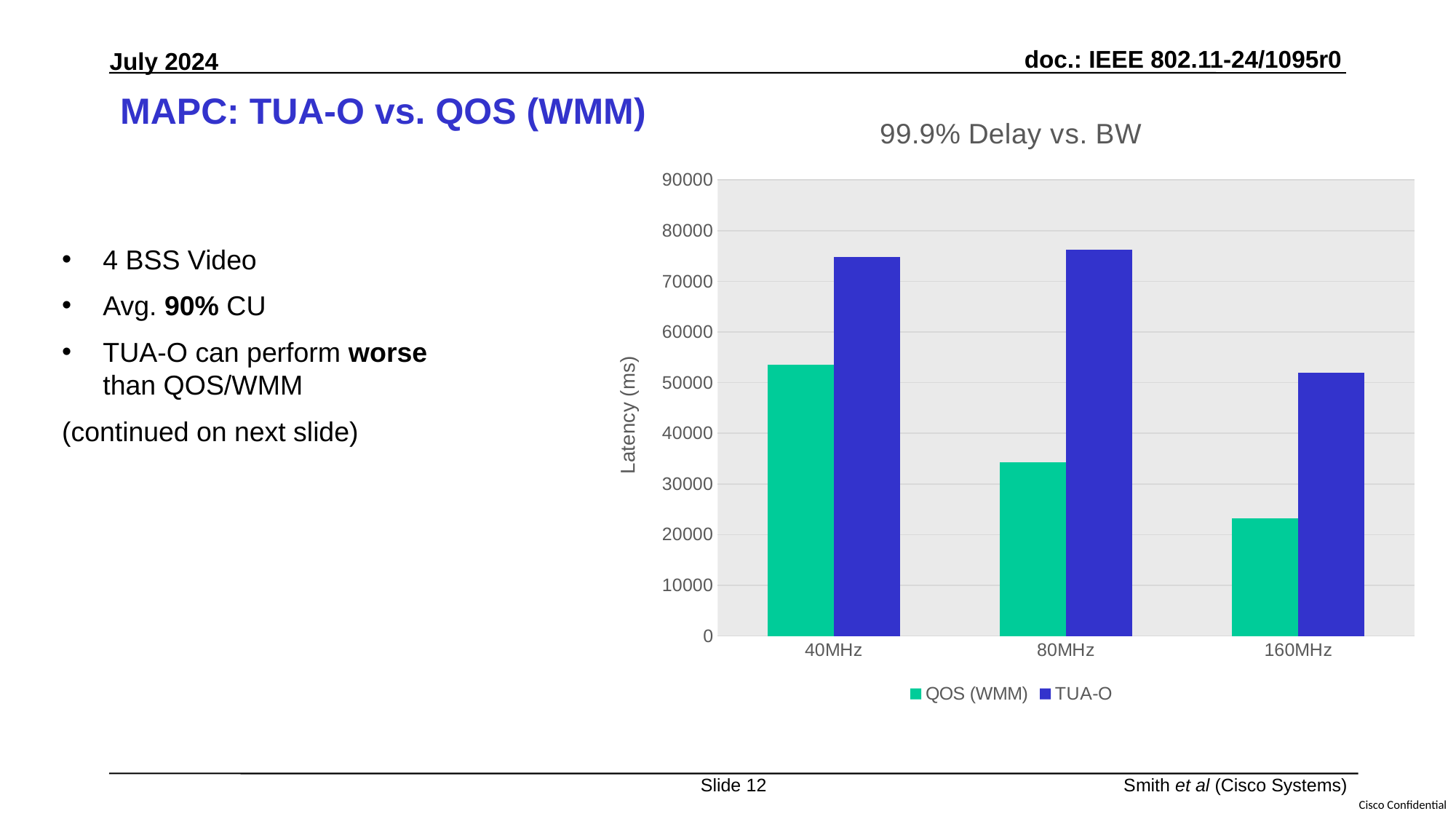
What kind of chart is shown on the slide? bar chart What is the title of the chart? 99.9% Delay vs. BW How many series does the chart legend list? 2 Is the QOS (WMM) value at 80MHz greater or less than 40000? less Do the QOS (WMM) values rise or fall as bandwidth increases from 40MHz to 160MHz? fall At 160MHz, which series has the lower latency, QOS (WMM) or TUA-O? QOS (WMM) For which bandwidth is the TUA-O latency lowest? 160MHz At 40MHz, which series has the higher latency, QOS (WMM) or TUA-O? TUA-O What is the label of the vertical axis? Latency (ms) Is the TUA-O value at 40MHz greater or less than 70000? greater For which bandwidth is the QOS (WMM) latency highest? 40MHz How many bandwidth categories are shown on the x axis? 3